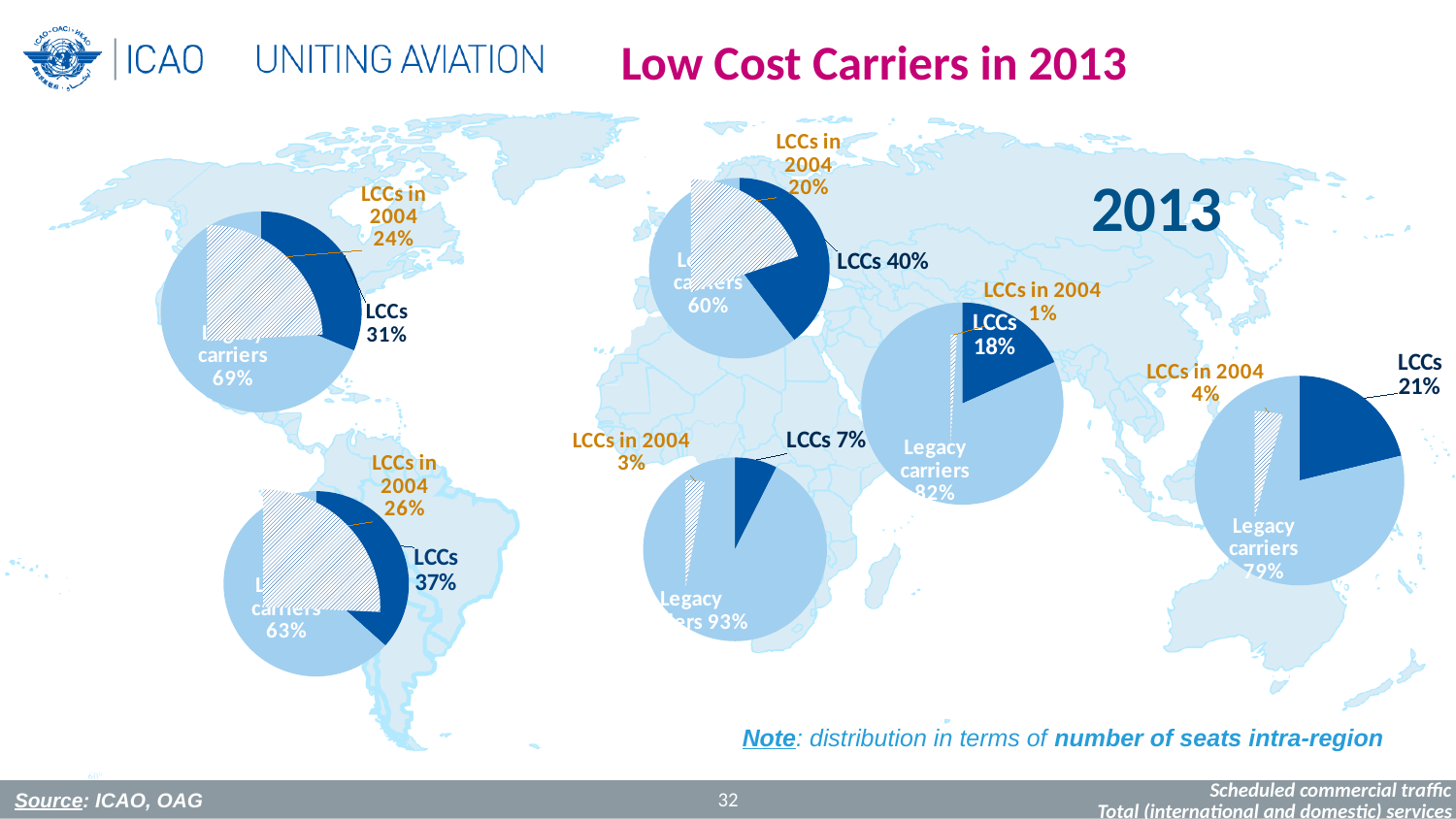
Across all the pie charts, which region's chart shows the highest LCC share in 2013? Europe (40%) What type of charts are shown on the slide? Pie charts In the pie chart over Africa, what share do legacy carriers have? 93% What is the title of the slide? Low Cost Carriers in 2013 In the pie chart over Europe, what share do LCCs have? 40% In the pie chart over Asia (the one labelled LCCs 18%), what was the LCC share in 2004? 1% In the pie chart over North America, what share do LCCs have? 31% In the pie chart over South America, what share do legacy carriers have? 63% Across all the pie charts, which region's chart shows the lowest LCC share in 2013? Africa (7%) How many pie charts are shown on the slide? 6 In the pie chart over Europe, by how many percentage points did the LCC share grow from 2004 to 2013? 20 percentage points Which is larger: the 2013 LCC share in the pie chart over South America or in the pie chart over North America? South America (37%)